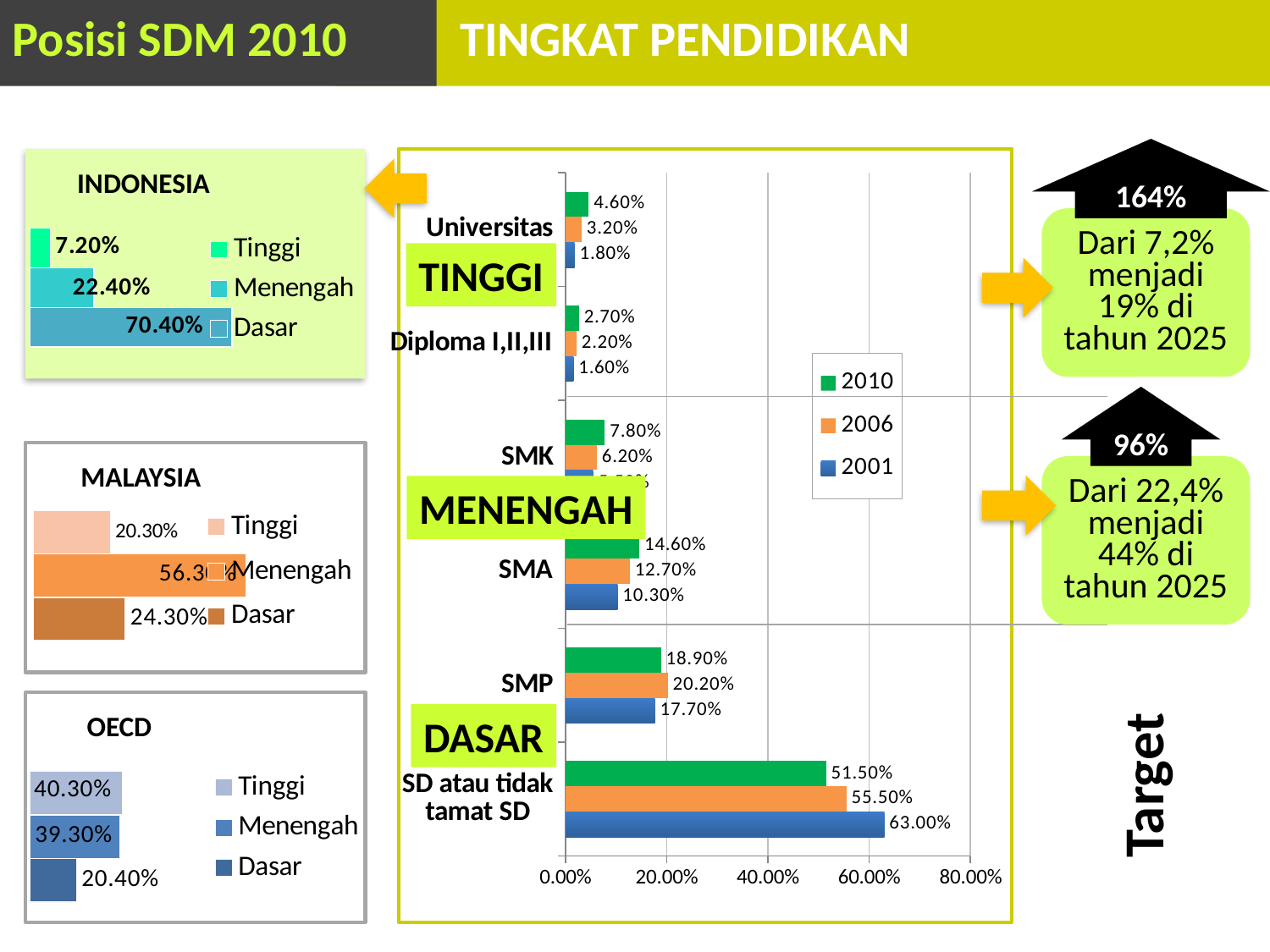
In the INDONESIA chart, what is the value for Dasar? 70.40% In the central chart, what is the difference between the 2001 and 2010 values for SD atau tidak tamat SD? 11.50% In the central chart, which category has the lowest 2010 value? Diploma I,II,III What kind of chart is the central chart? bar chart In the central chart, what is the 2006 value for SMP? 20.20% In the central chart, which is larger for SMA: the 2010 value or the 2006 value? 2010 In the central chart, what is the 2010 value for SD atau tidak tamat SD? 51.50% In the MALAYSIA chart, what is the value for Tinggi? 20.30% In the central chart, what is the 2001 value for Universitas? 1.80% In the central chart, which category has the highest 2001 value? SD atau tidak tamat SD In the OECD chart, which category has the lowest value? Dasar In the central chart, how many series does the legend list? 3